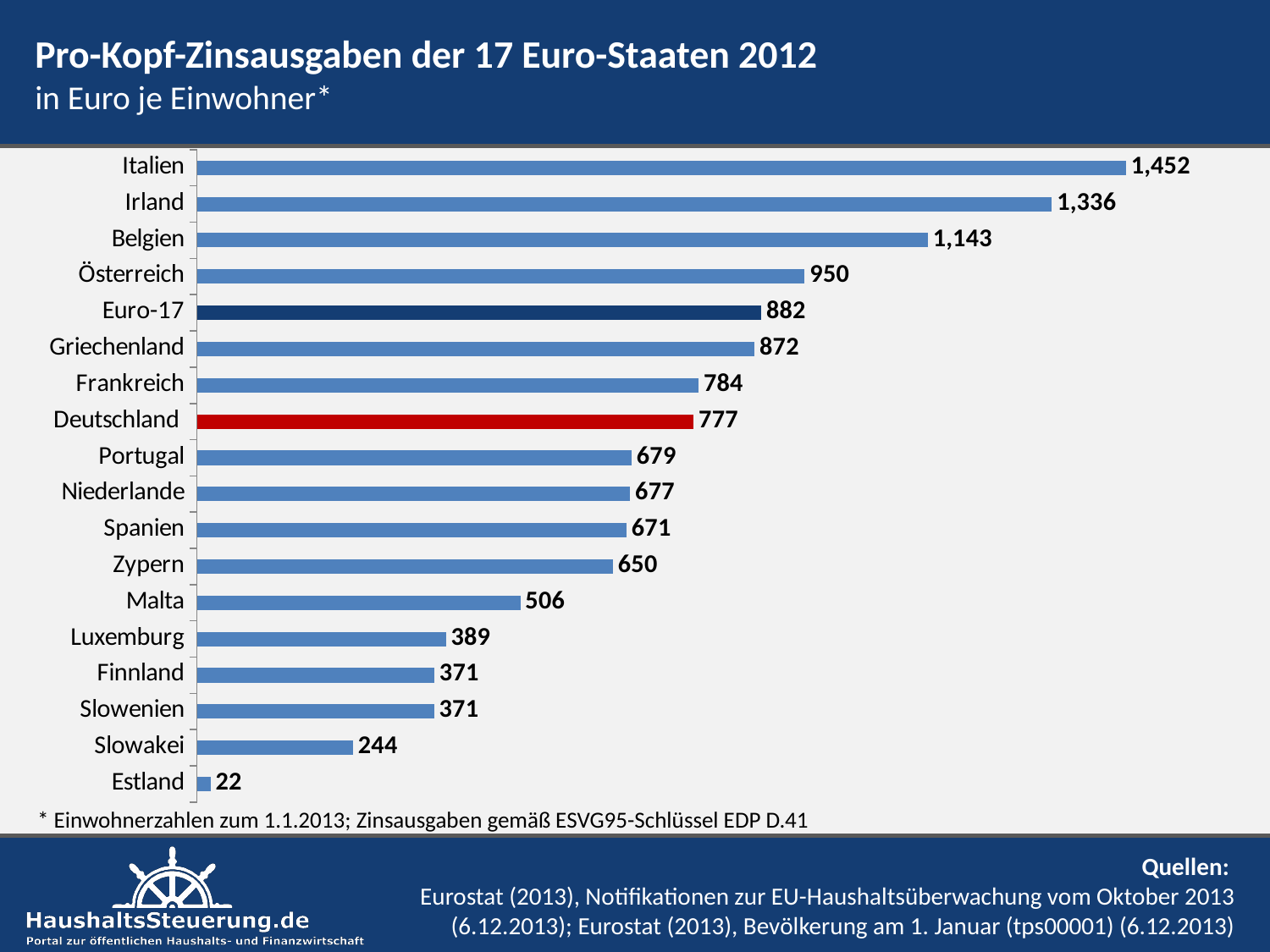
Which category has the lowest value? Estland What is the value for Estland? 22 What is the value for Deutschland? 777 Which bar is coloured red? Deutschland Which category has the highest value? Italien What is the difference between the values for Italien and Irland? 116 What is the value for Italien? 1,452 What kind of chart is shown on the slide? bar chart What is the value for Euro-17? 882 Which is larger, the value for Belgien or the value for Österreich? Belgien What is the difference between the values for Euro-17 and Deutschland? 105 How many bars are shown in the chart? 18